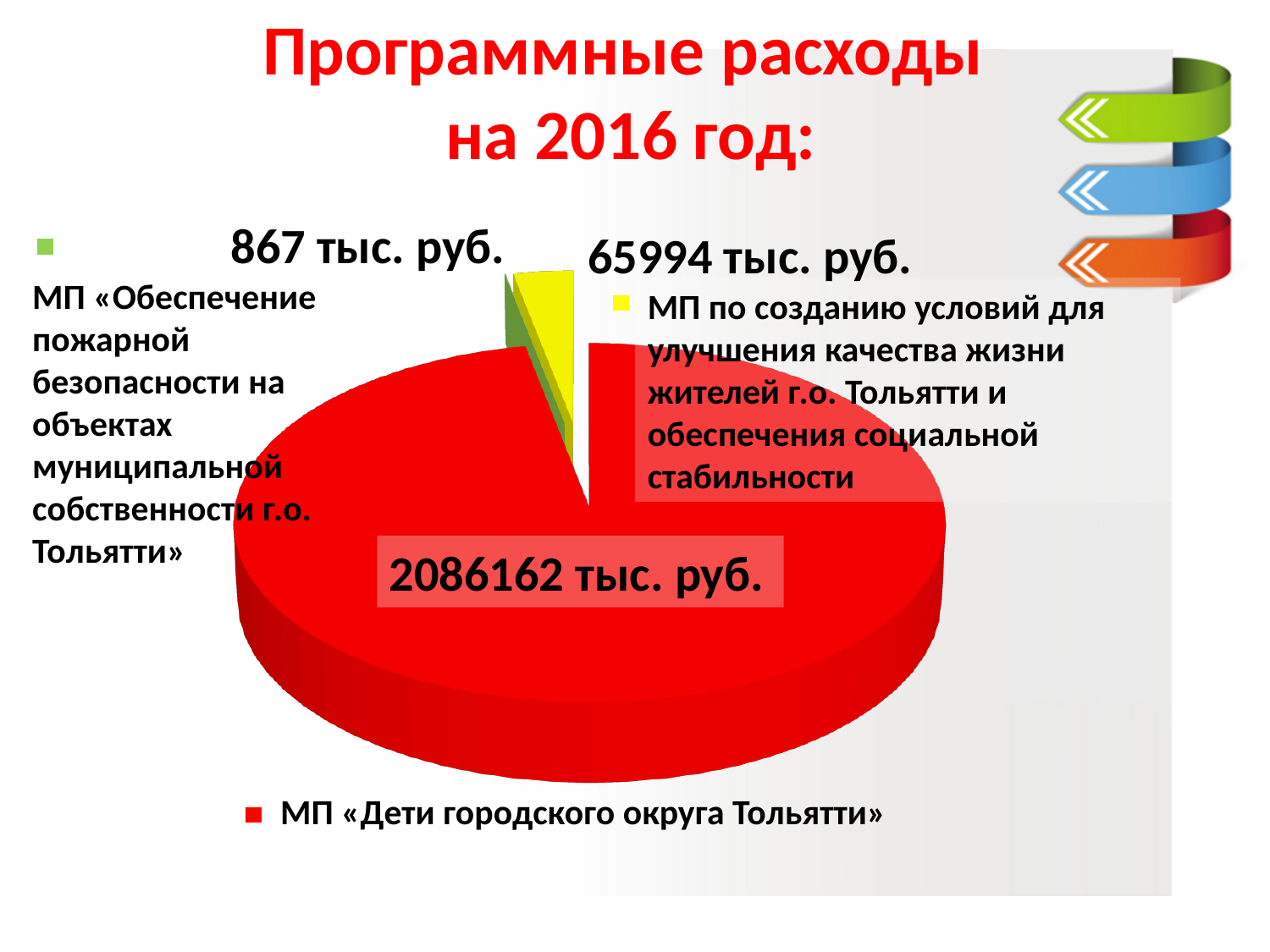
Which programme has the smallest slice of the pie? МП «Обеспечение пожарной безопасности на объектах муниципальной собственности г.о. Тольятти» What is the difference between the value for МП «Дети городского округа Тольятти» and the value for МП по созданию условий для улучшения качества жизни жителей г.о. Тольятти и обеспечения социальной стабильности? 2020168 тыс. руб. What kind of chart is shown on the slide? Pie chart Which is larger: the value for МП по созданию условий для улучшения качества жизни жителей г.о. Тольятти и обеспечения социальной стабильности or the value for МП «Обеспечение пожарной безопасности на объектах муниципальной собственности г.о. Тольятти»? МП по созданию условий для улучшения качества жизни жителей г.о. Тольятти и обеспечения социальной стабильности What is the value for МП «Обеспечение пожарной безопасности на объектах муниципальной собственности г.о. Тольятти»? 867 тыс. руб. What is the title of the slide containing the chart? Программные расходы на 2016 год What is the difference between the value for МП по созданию условий для улучшения качества жизни жителей г.о. Тольятти и обеспечения социальной стабильности and the value for МП «Обеспечение пожарной безопасности на объектах муниципальной собственности г.о. Тольятти»? 65127 тыс. руб. What is the value for МП «Дети городского округа Тольятти»? 2086162 тыс. руб. Which programme has the largest slice of the pie? МП «Дети городского округа Тольятти» What colour is the slice for МП «Дети городского округа Тольятти»? Red How many slices does the pie chart have? 3 What is the value for МП по созданию условий для улучшения качества жизни жителей г.о. Тольятти и обеспечения социальной стабильности? 65994 тыс. руб.